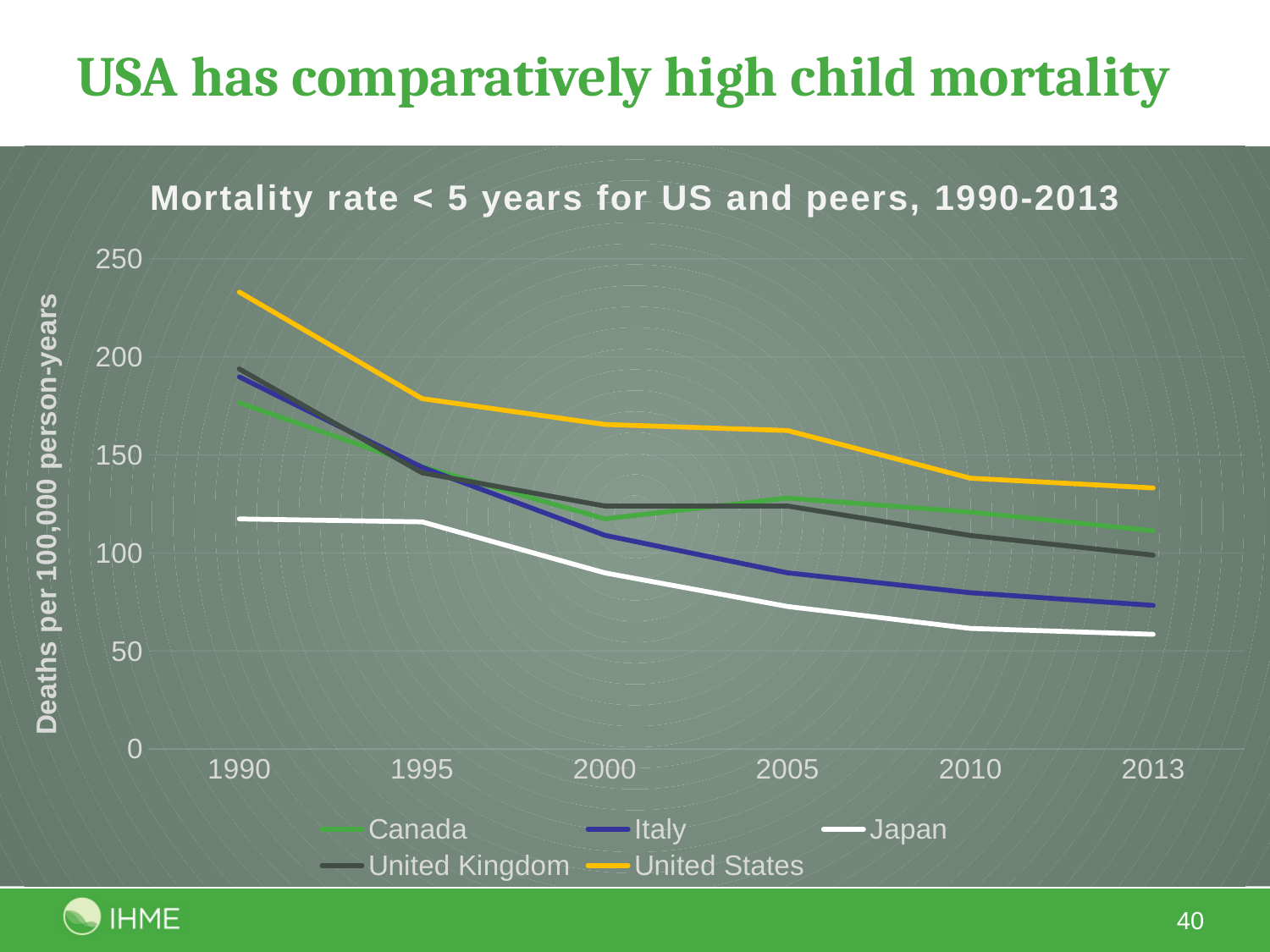
What is the title of the chart? Mortality rate < 5 years for US and peers, 1990-2013 Does the United States line rise or fall from 1990 to 2013? fall How many series does the legend list? 5 Is the value for Italy in 2000 greater or less than 150? less Is the value for Japan in 2013 greater or less than 100? less What is the label on the y axis? Deaths per 100,000 person-years In 2013, which is higher: Canada or Italy? Canada Is the value for the United States in 1990 greater or less than 200? greater Which country has the lowest mortality rate in 2013? Japan Which country has the highest mortality rate in 2013? United States How many years are marked along the x axis? 6 What kind of chart is shown on the slide? line chart